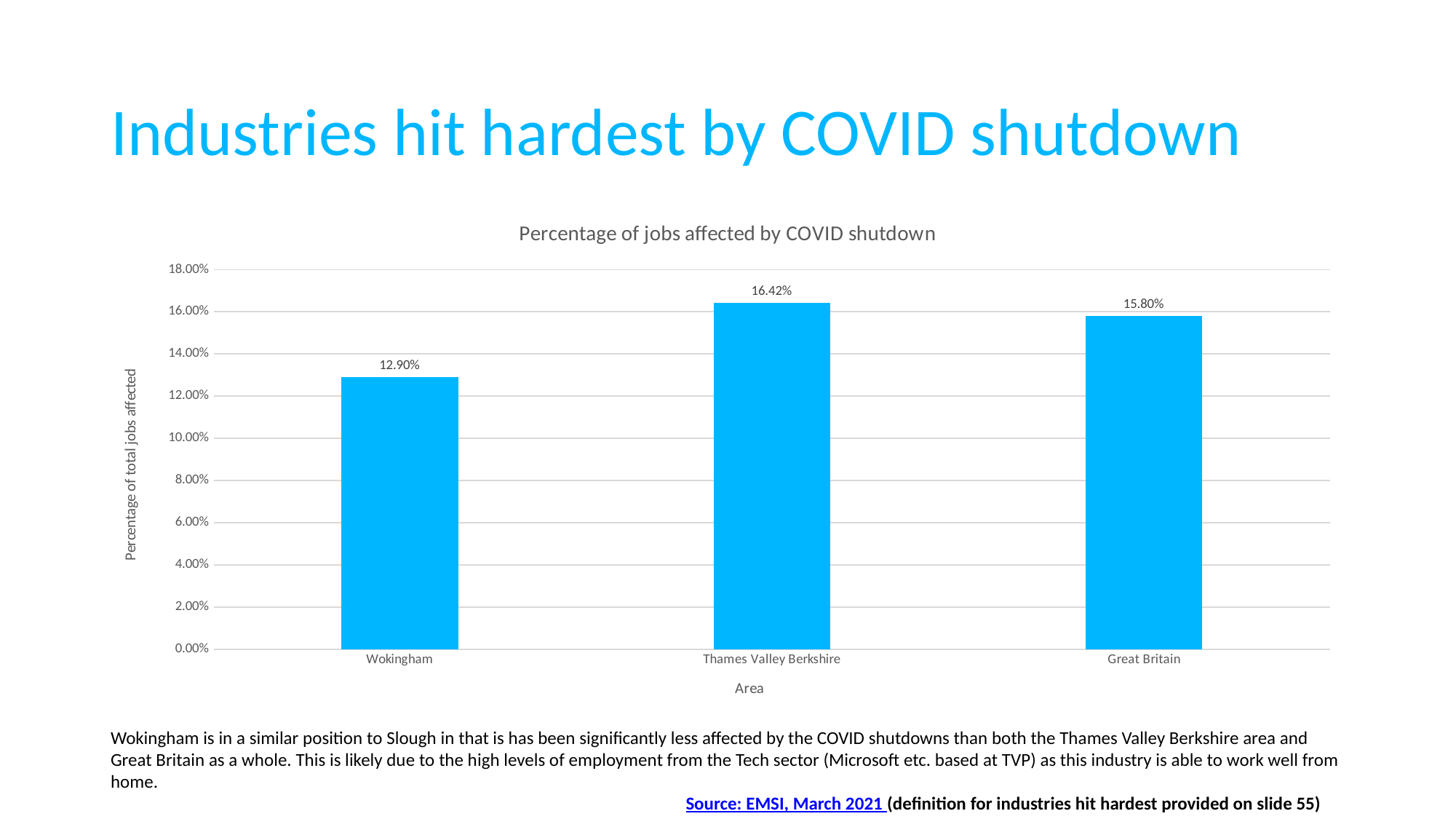
Which area has the lowest percentage of jobs affected by COVID shutdown? Wokingham What is the percentage of jobs affected by COVID shutdown for Wokingham? 12.90% What kind of chart is shown on the slide? Bar chart Which area has the highest percentage of jobs affected by COVID shutdown? Thames Valley Berkshire Is the value for Wokingham greater or less than 14.00%? less How many areas are shown on the chart? 3 What is the difference in percentage points between Thames Valley Berkshire and Wokingham? 3.52% What is the percentage of jobs affected by COVID shutdown for Thames Valley Berkshire? 16.42% What is the difference in percentage points between Great Britain and Wokingham? 2.90% What is the percentage of jobs affected by COVID shutdown for Great Britain? 15.80% Which has a higher percentage of jobs affected: Great Britain or Thames Valley Berkshire? Thames Valley Berkshire What is the title of the chart? Percentage of jobs affected by COVID shutdown